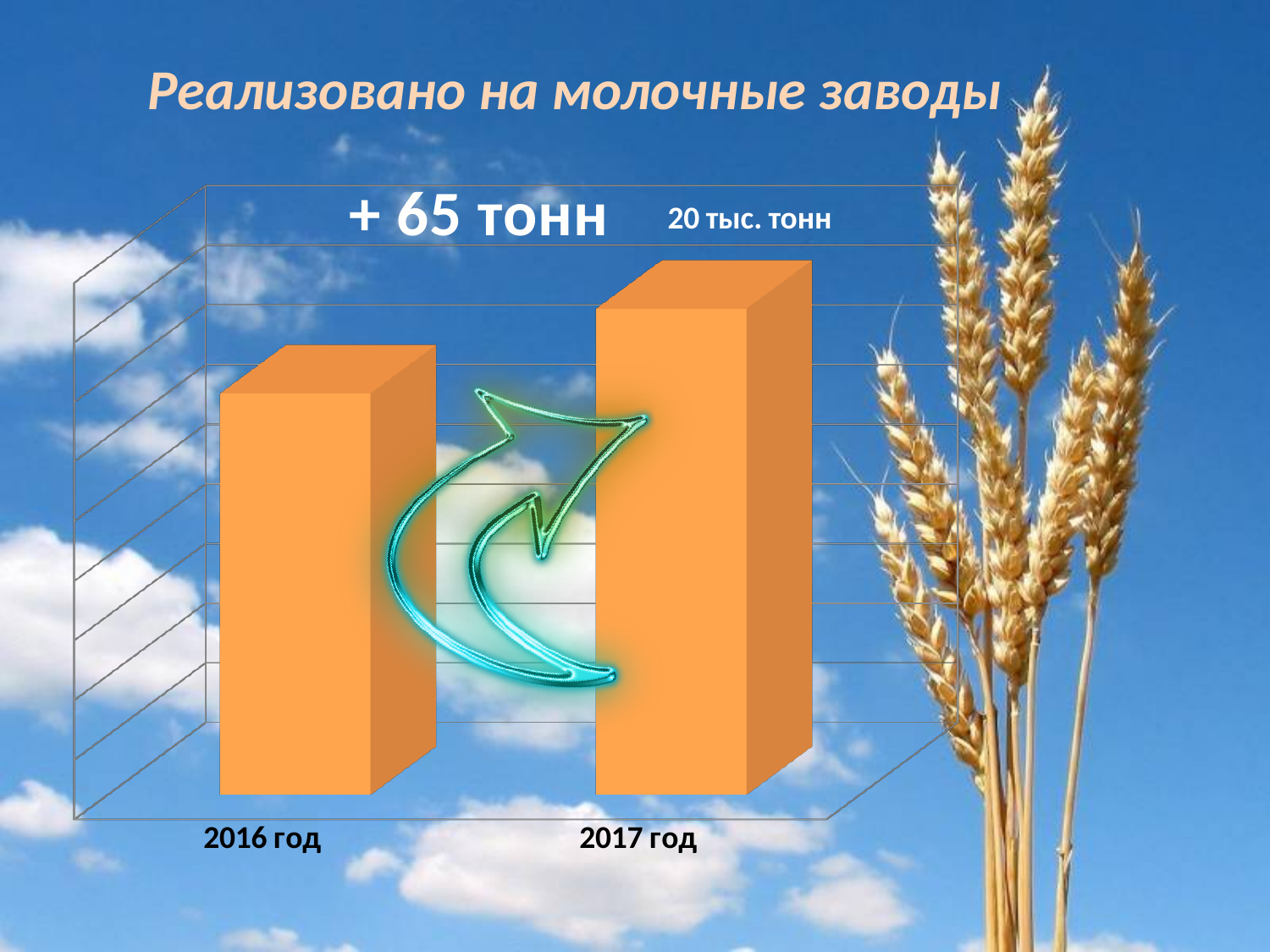
Which year has the lowest bar in the chart? 2016 год What kind of chart is shown on the slide? bar chart Which year has the highest bar in the chart? 2017 год What increase is annotated above the bars in the chart? + 65 тонн Do the values rise or fall from 2016 год to 2017 год? rise How many categories (bars) does the chart show? 2 Which bar is taller, 2016 год or 2017 год? 2017 год What is the title of the chart on the slide? Реализовано на молочные заводы